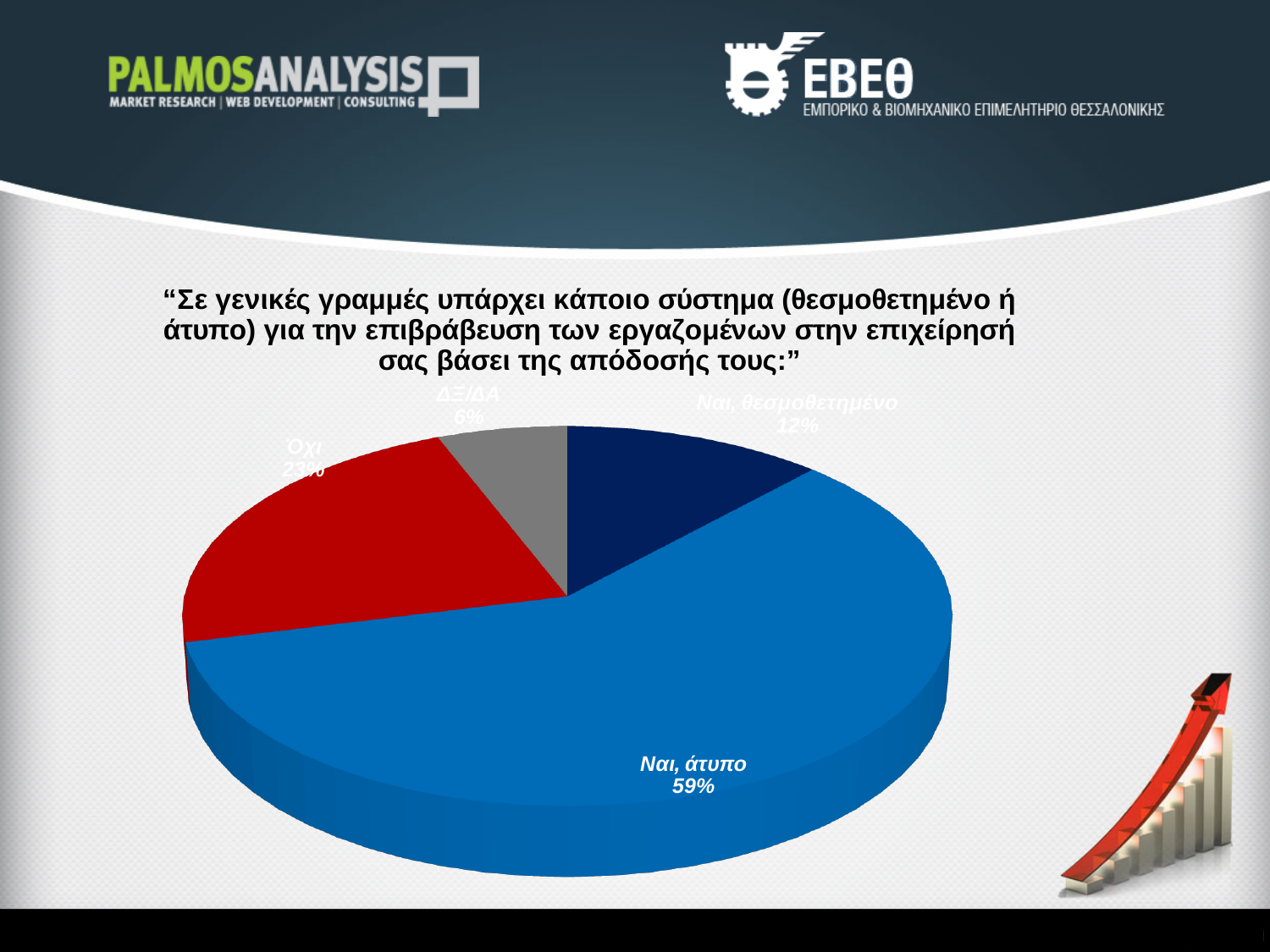
What colour is the "Όχι" slice of the pie chart? red Which slice of the pie chart is the largest? Ναι, άτυπο What share of the pie does "Όχι" represent? 23% Which slice of the pie chart is the smallest? ΔΞ/ΔΑ What share of the pie does "Ναι, θεσμοθετημένο" represent? 12% What is the combined share of the two "Ναι" slices ("Ναι, θεσμοθετημένο" and "Ναι, άτυπο")? 71% Which is larger, the share for "Όχι" or the share for "Ναι, θεσμοθετημένο"? Όχι What kind of chart is shown on the slide? pie chart What share of the pie does "ΔΞ/ΔΑ" represent? 6% What is the difference in percentage points between "Ναι, άτυπο" and "Όχι"? 36 How many slices does the pie chart have? 4